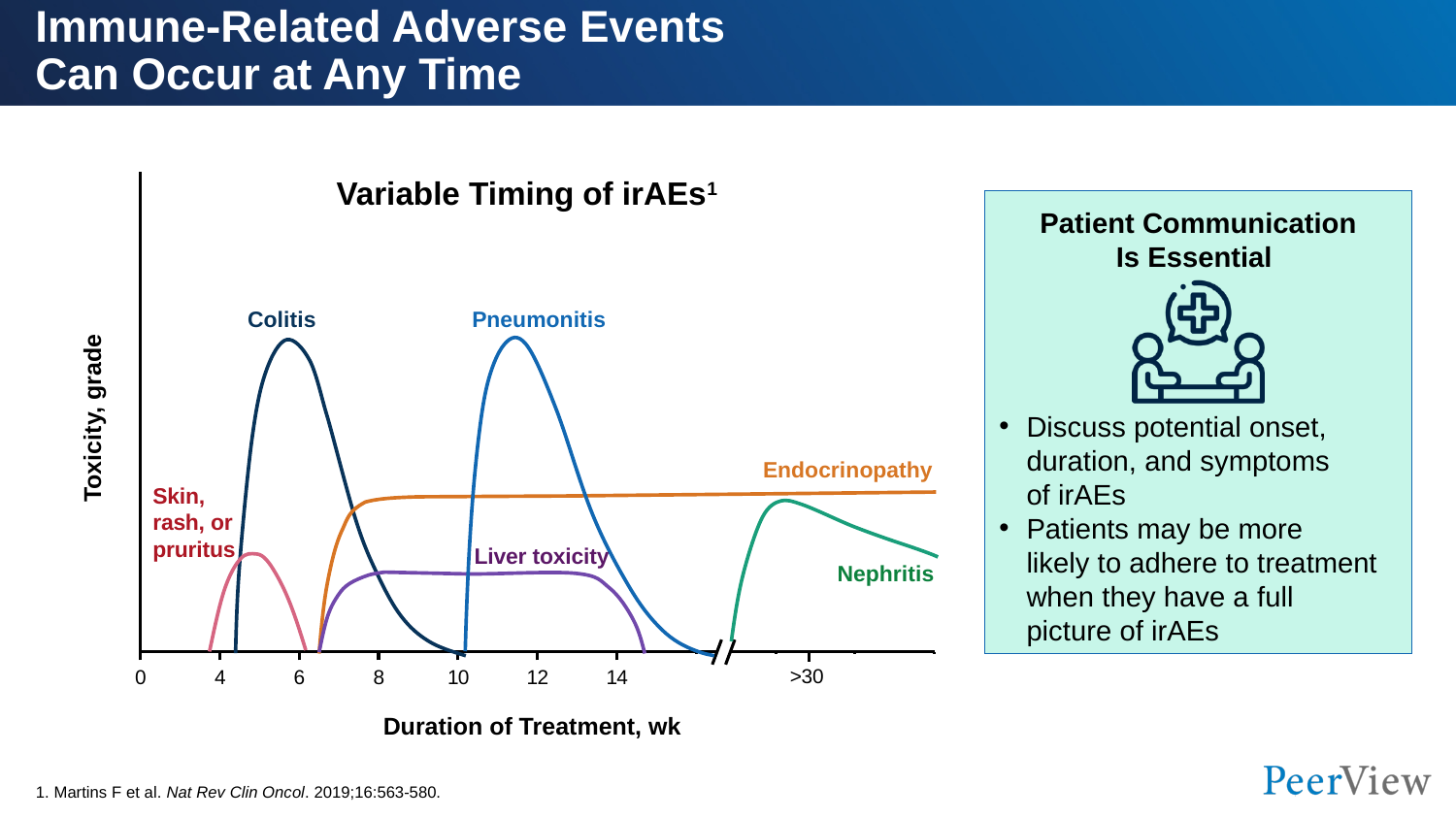
Which adverse-event curve begins earliest along the x axis on the "Variable Timing of irAEs" chart? Skin, rash, or pruritus On the "Variable Timing of irAEs" chart, which peaks higher, Colitis or Liver toxicity? Colitis Which adverse-event curve has the lowest peak on the "Variable Timing of irAEs" chart? Skin, rash, or pruritus On the "Variable Timing of irAEs" chart, which curve reaches a higher level, Endocrinopathy or Liver toxicity? Endocrinopathy On the "Variable Timing of irAEs" chart, does the Pneumonitis curve peak before or after week 10? after On the "Variable Timing of irAEs" chart, which peaks higher, Nephritis or Skin, rash, or pruritus? Nephritis What is the label of the x axis on the "Variable Timing of irAEs" chart? Duration of Treatment, wk What kind of chart is shown under the title "Variable Timing of irAEs"? Line chart What is the label of the y axis on the "Variable Timing of irAEs" chart? Toxicity, grade On the "Variable Timing of irAEs" chart, does the Colitis curve peak before or after week 8? before On the "Variable Timing of irAEs" chart, does the Nephritis curve rise or fall after its peak toward the >30 week mark? fall How many adverse-event curves are plotted on the "Variable Timing of irAEs" chart? 6